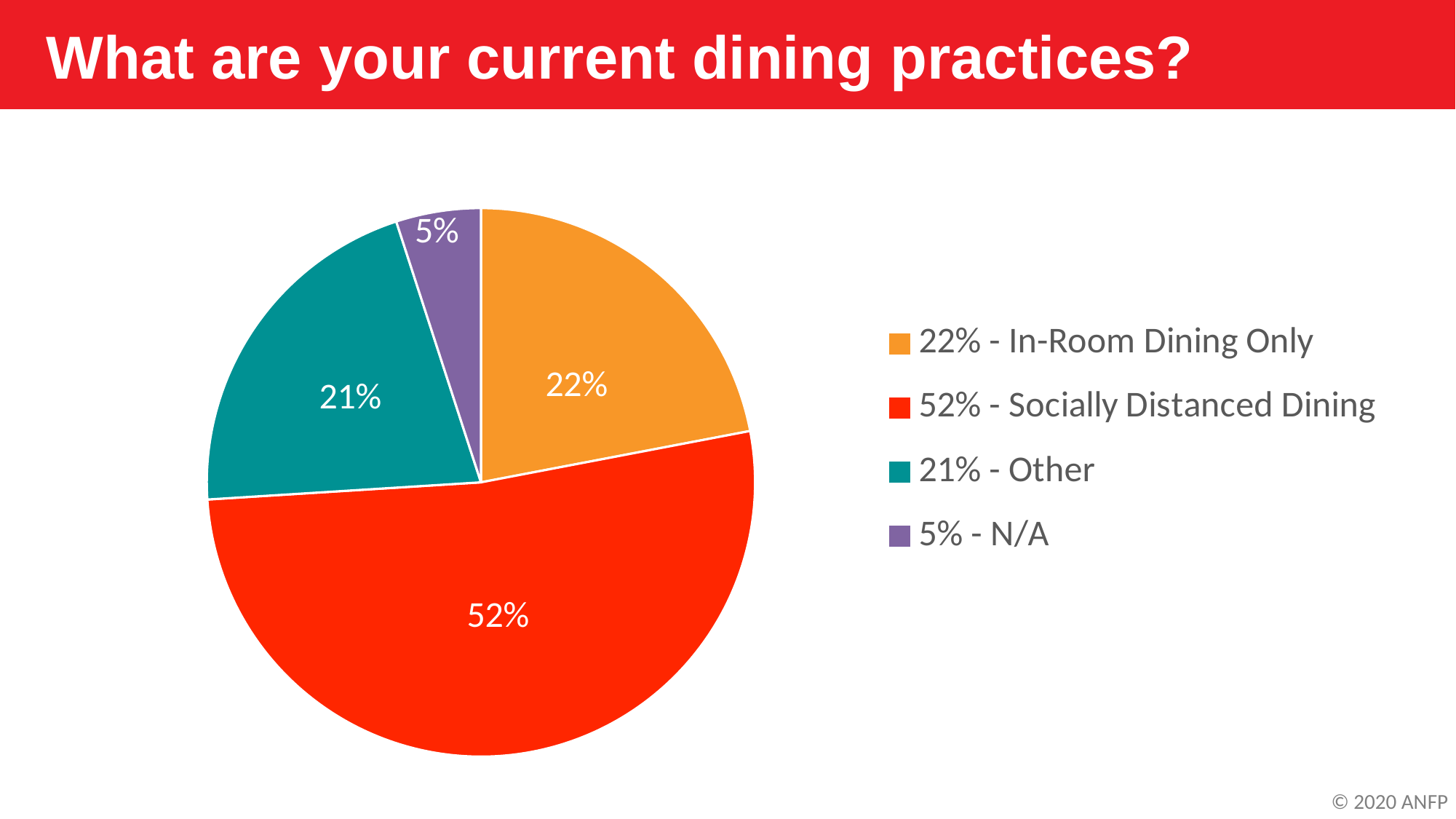
Which category has the largest slice of the pie? Socially Distanced Dining What kind of chart is shown on the slide? pie chart What share of the pie is Socially Distanced Dining? 52% What colour is the slice for Other? teal What share of the pie is N/A? 5% How many slices does the pie chart have? 4 Which is larger, the share for Other or the share for N/A? Other What is the difference in percentage points between Socially Distanced Dining and In-Room Dining Only? 30 What share of the pie is In-Room Dining Only? 22% Which category has the smallest slice of the pie? N/A What is the title of the slide? What are your current dining practices?